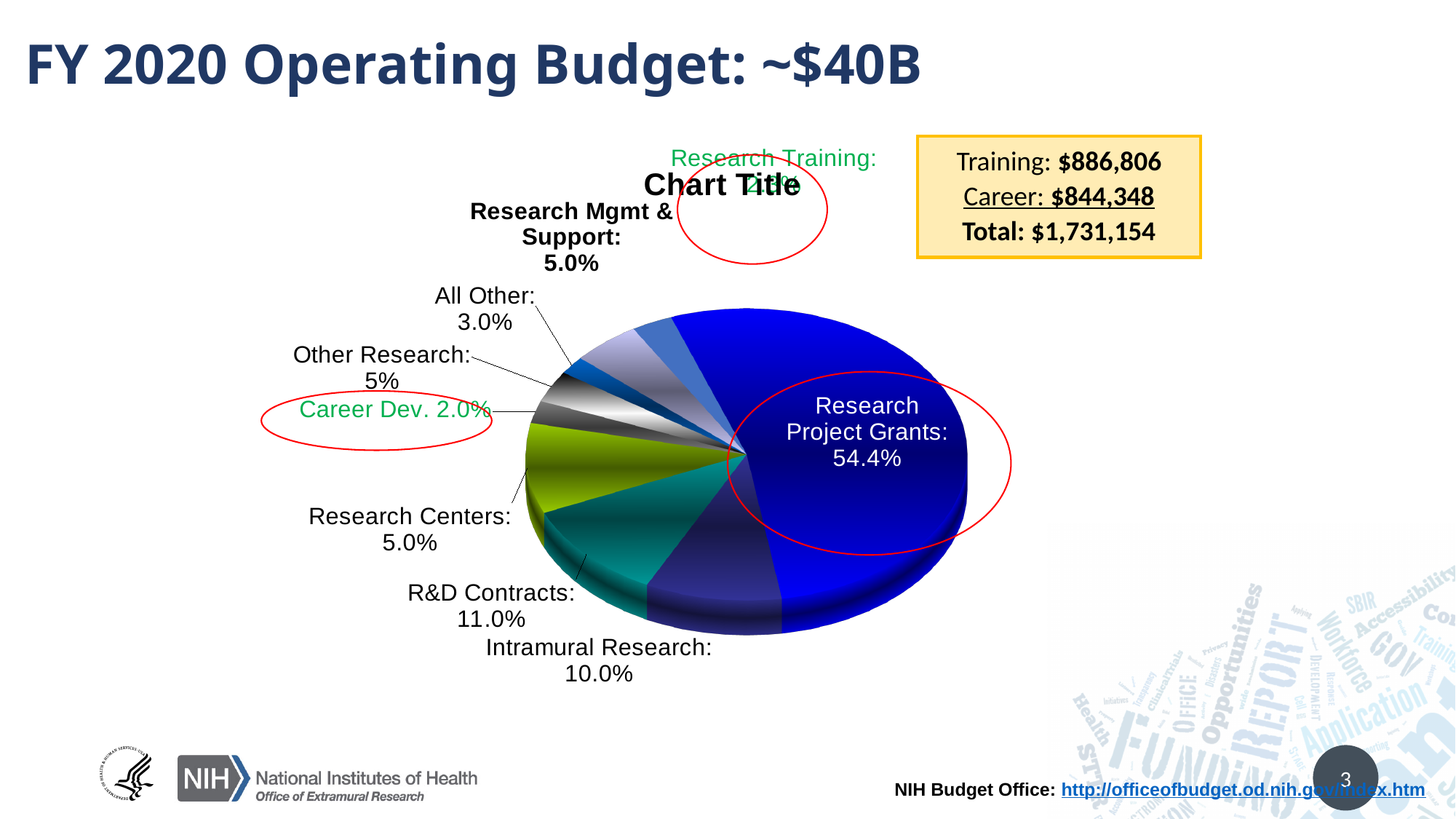
What is the difference in percentage points between R&D Contracts and Intramural Research? 1.0 What percentage of the pie is Research Project Grants? 54.4% Which category has the largest slice of the pie? Research Project Grants What is the title printed above the pie chart? Chart Title How many categories are labeled on the pie chart? 9 Which is larger, R&D Contracts or Intramural Research? R&D Contracts What is the value shown for R&D Contracts? 11.0% What is the value shown for Research Mgmt & Support? 5.0% What type of chart is shown on the slide? pie chart What is the value shown for Intramural Research? 10.0% What is the value shown for Career Dev.? 2.0% What is the value shown for All Other? 3.0%